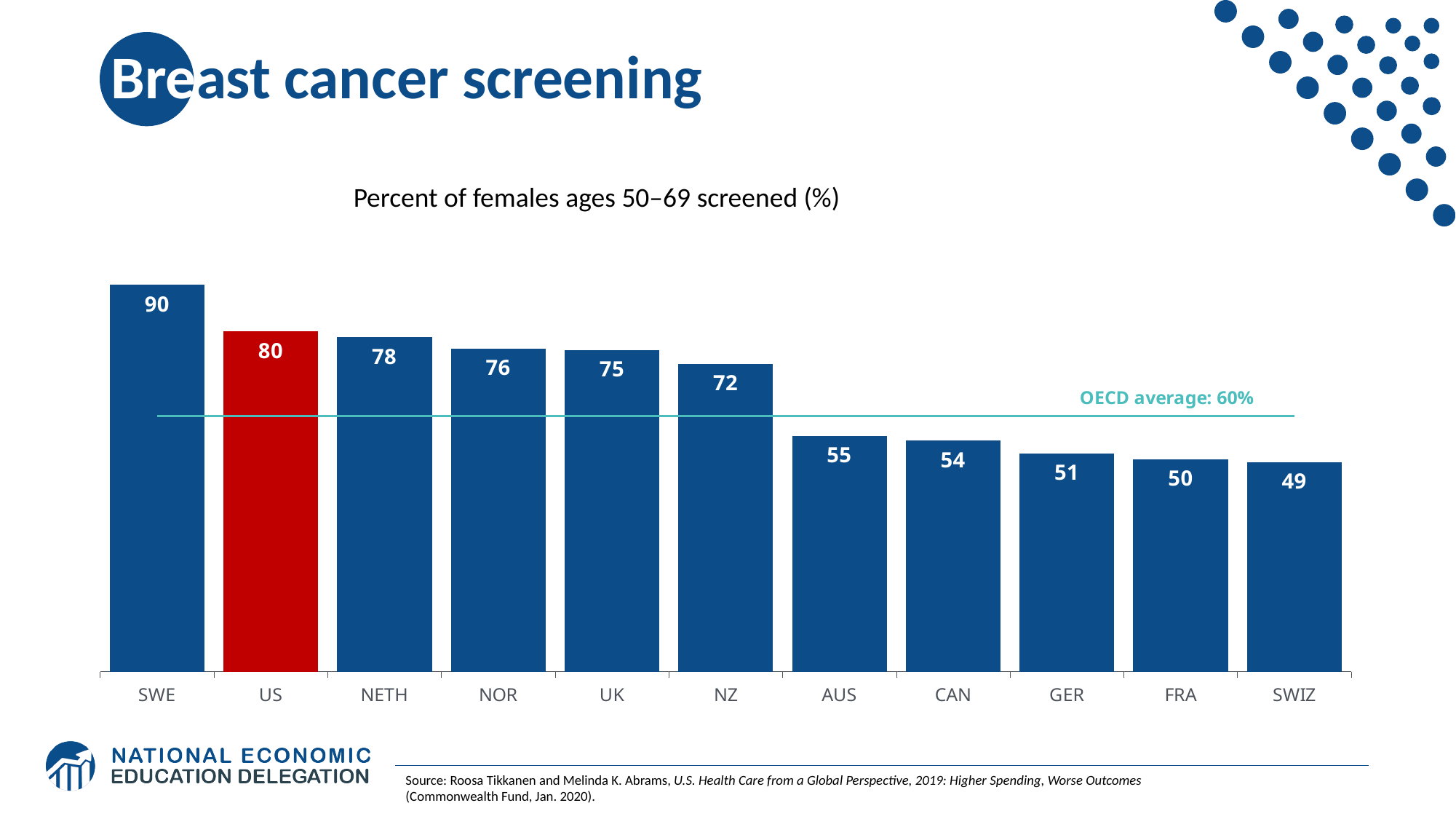
Which country's bar is coloured red? US What kind of chart is this? bar chart Which country has the highest value? SWE What is the value for the US? 80 What is the difference between the values for SWE and the US? 10 What is the difference between the values for NZ and AUS? 17 What is the value for FRA? 50 Which country has the lowest value? SWIZ How many countries are shown on the chart? 11 What is the OECD average shown on the chart? 60% What is the value for NZ? 72 Which is larger, the value for NETH or the value for CAN? NETH